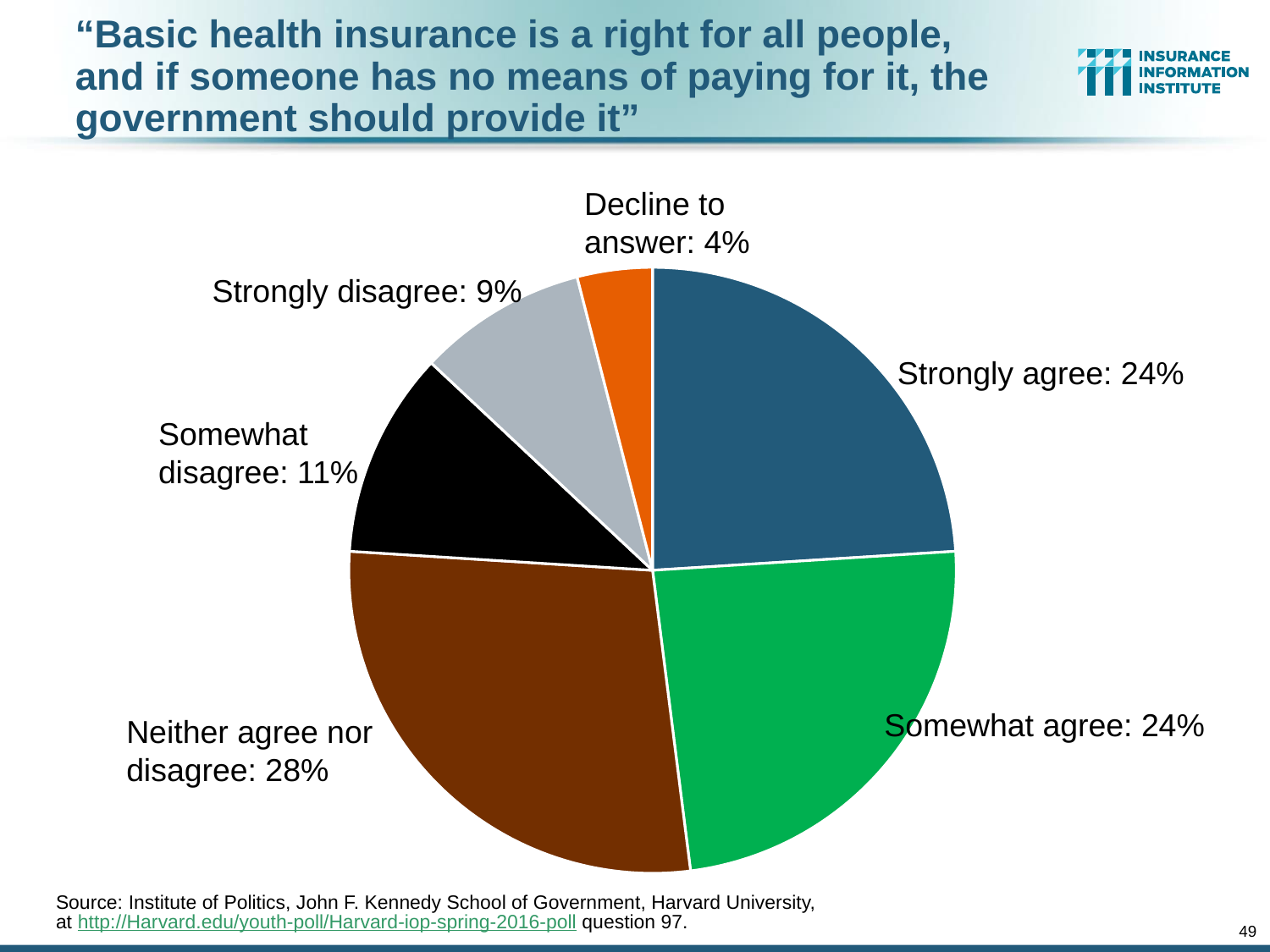
What percentage of respondents declined to answer? 4% What percentage of respondents chose 'Strongly agree'? 24% What percentage of respondents chose 'Neither agree nor disagree'? 28% What is the difference in percentage points between 'Neither agree nor disagree' and 'Strongly disagree'? 19 Which response category has the smallest share of the pie? Decline to answer What is the combined share of 'Strongly agree' and 'Somewhat agree'? 48% What percentage of respondents chose 'Somewhat disagree'? 11% Which response category has the largest share of the pie? Neither agree nor disagree What colour is the 'Somewhat agree' slice? Green How many slices does the pie chart have? 6 Which is larger: the share for 'Somewhat disagree' or the share for 'Strongly disagree'? Somewhat disagree What kind of chart is shown on the slide? Pie chart